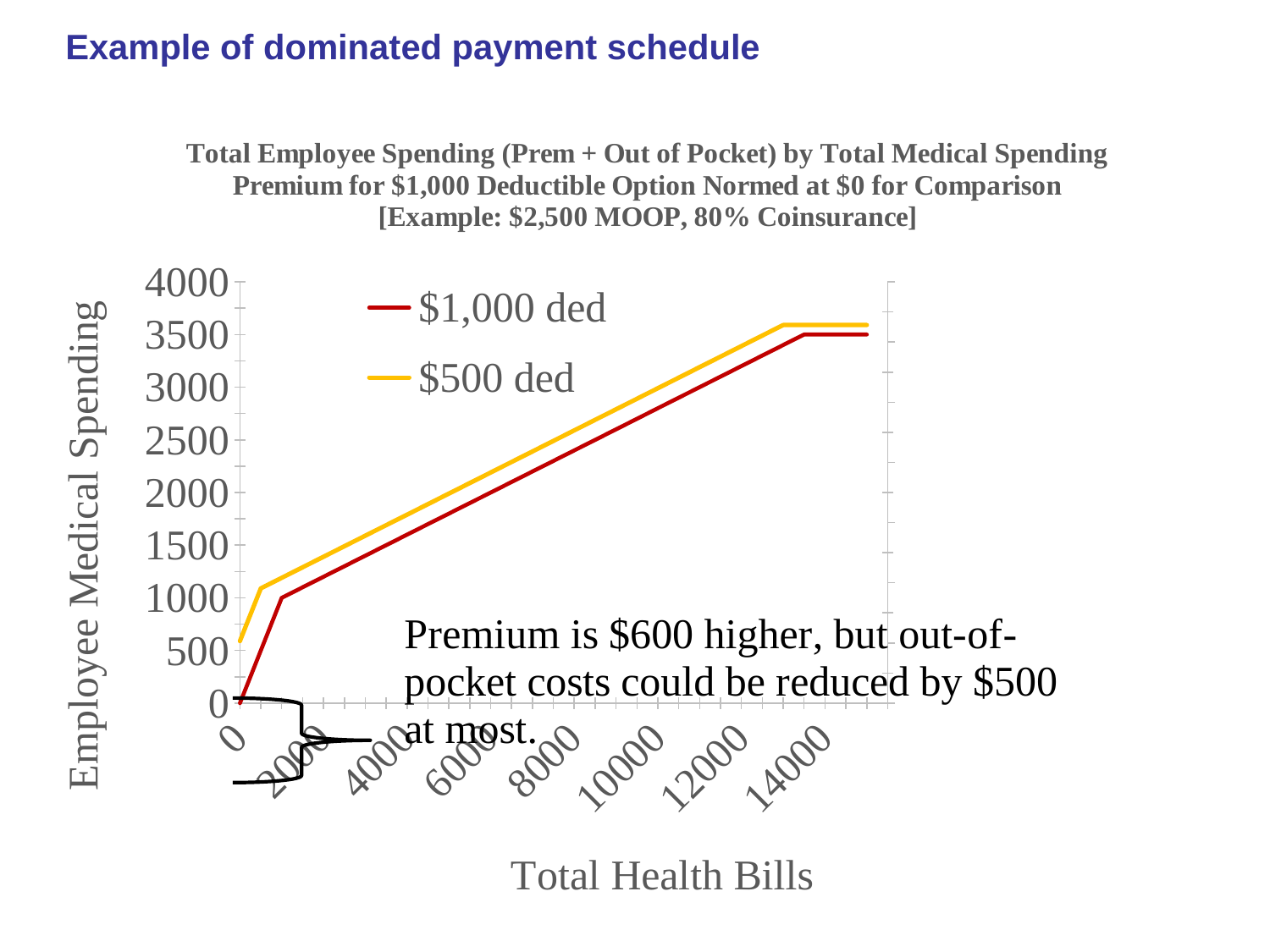
Is the value for the $1,000 ded series at Total Health Bills of 2000 greater or less than 1000? greater Do the values of the $1,000 ded series rise or fall as Total Health Bills increase? rise Which series is drawn in yellow? $500 ded Is the value for the $500 ded series at Total Health Bills of 14000 greater or less than 3500? greater What kind of chart is shown on the slide? line chart How many series does the chart legend list? 2 What is the value of the $1,000 ded series at Total Health Bills of 0? 0 Is the value for the $500 ded series at Total Health Bills of 0 greater or less than 500? greater Which series is higher at Total Health Bills of 8000, $1,000 ded or $500 ded? $500 ded What is the title of the x axis? Total Health Bills